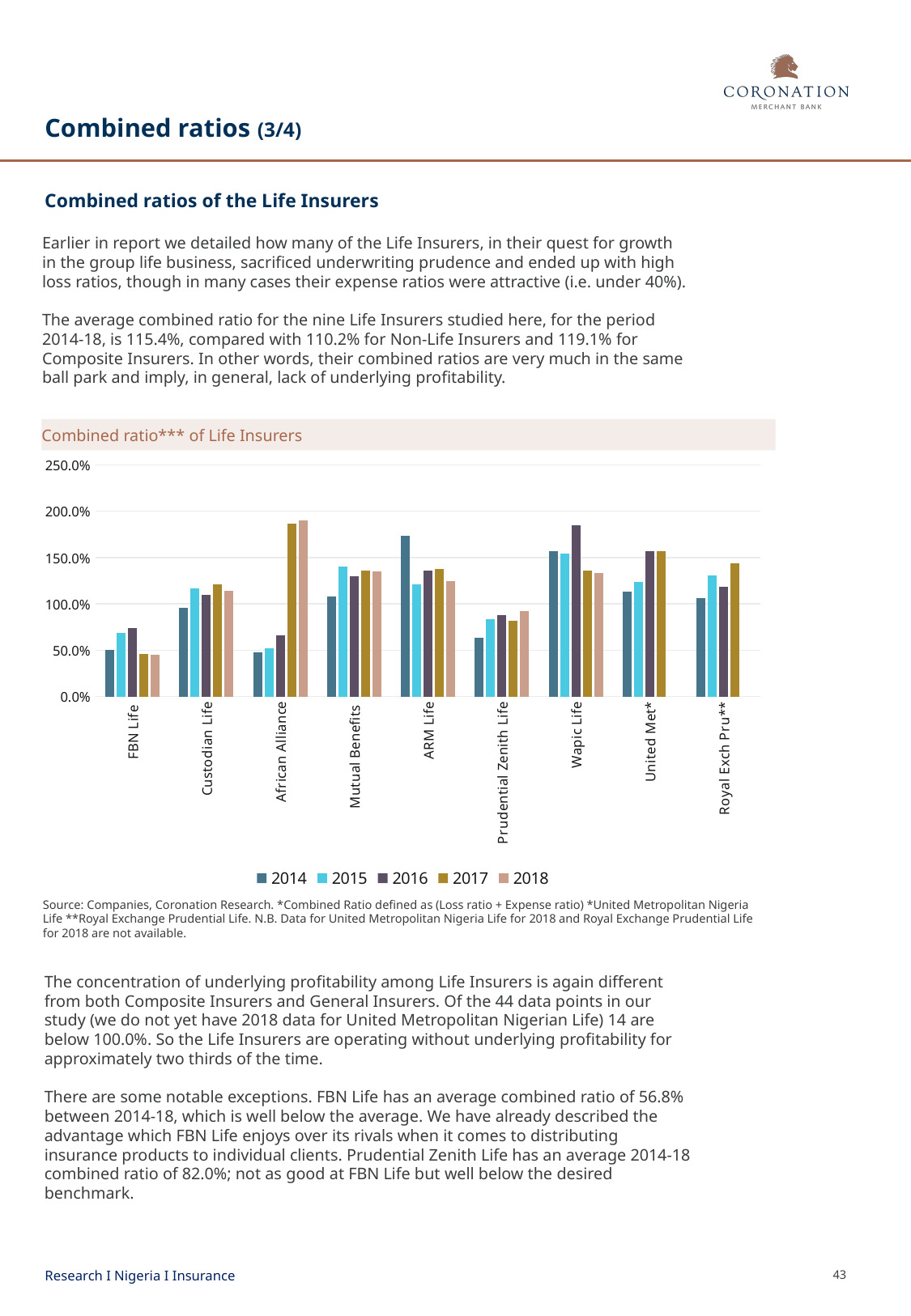
How many series does the chart's legend list? 5 Which years are listed in the chart's legend? 2014, 2015, 2016, 2017, 2018 Do the values for African Alliance rise or fall from 2014 to 2018? rise What is the title of the chart? Combined ratio*** of Life Insurers Which insurer has the highest combined ratio for 2016? Wapic Life Which is larger: the 2018 value for African Alliance or the 2018 value for FBN Life? African Alliance How many insurers (categories) are shown on the x axis of the chart? 9 Which insurer has the lowest combined ratio for 2017? FBN Life Is the 2017 value for African Alliance greater or less than 150.0%? greater Which insurer has the highest combined ratio for 2017? African Alliance What kind of chart is shown on the slide? Bar chart Is the 2014 value for FBN Life greater or less than 100.0%? less